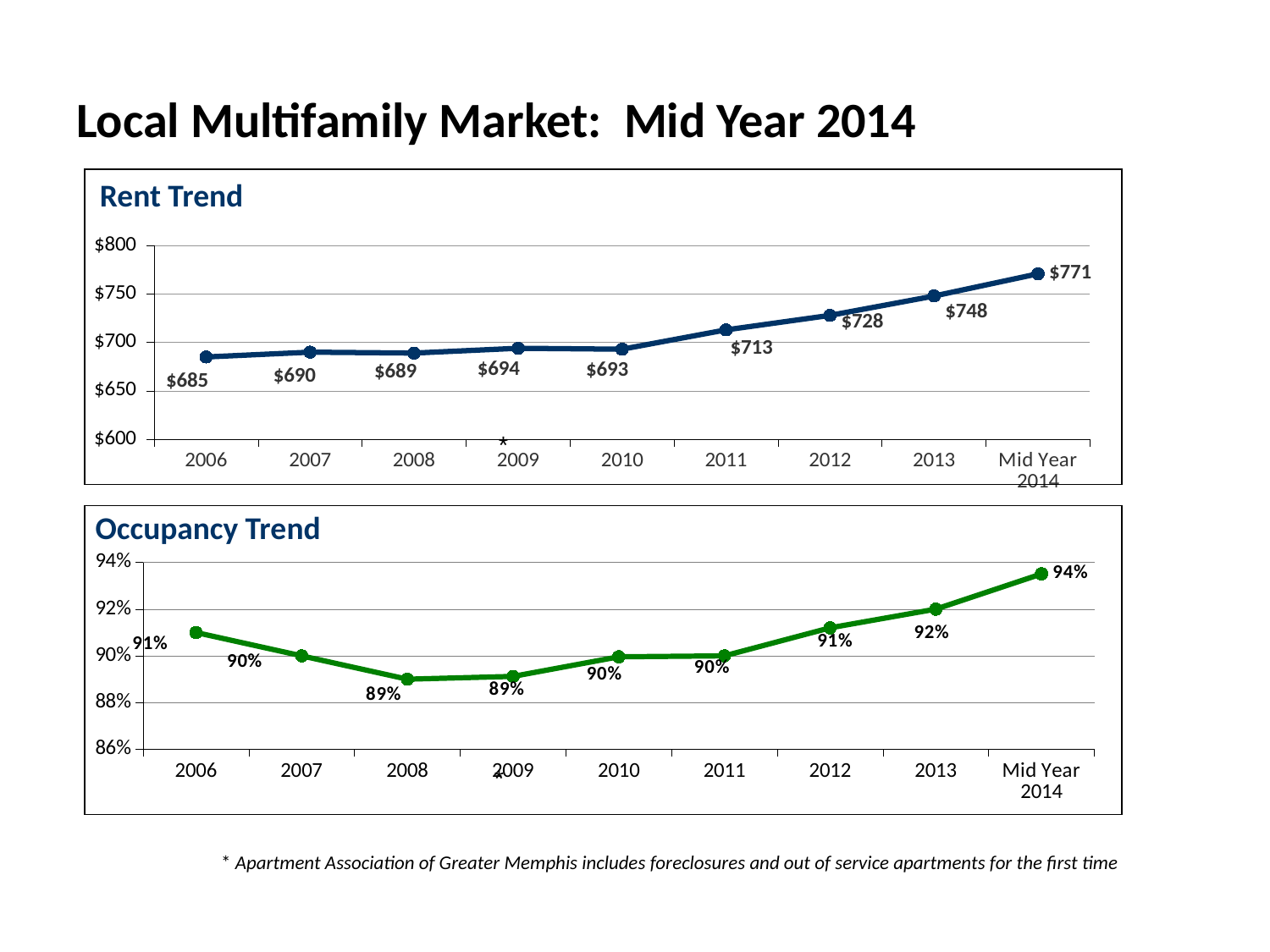
In the Rent Trend chart, what is the difference between the rent for 2013 and the rent for 2012? $20 In the Rent Trend chart, which is larger, the rent for 2009 or the rent for 2010? 2009 In the Rent Trend chart, which year has the lowest rent value? 2006 In the Occupancy Trend chart, which period has the highest occupancy? Mid Year 2014 In the Occupancy Trend chart, what is the difference between the occupancy for Mid Year 2014 and the occupancy for 2009? 5% In the Rent Trend chart, what is the rent value for 2011? $713 In the Rent Trend chart, what is the rent value for Mid Year 2014? $771 In the Occupancy Trend chart, what is the occupancy value for 2008? 89% In the Rent Trend chart, how many data points are plotted? 9 What colour is the line in the Occupancy Trend chart? Green What type of chart is the Rent Trend chart? Line chart In the Occupancy Trend chart, do the values rise or fall from 2011 to Mid Year 2014? Rise